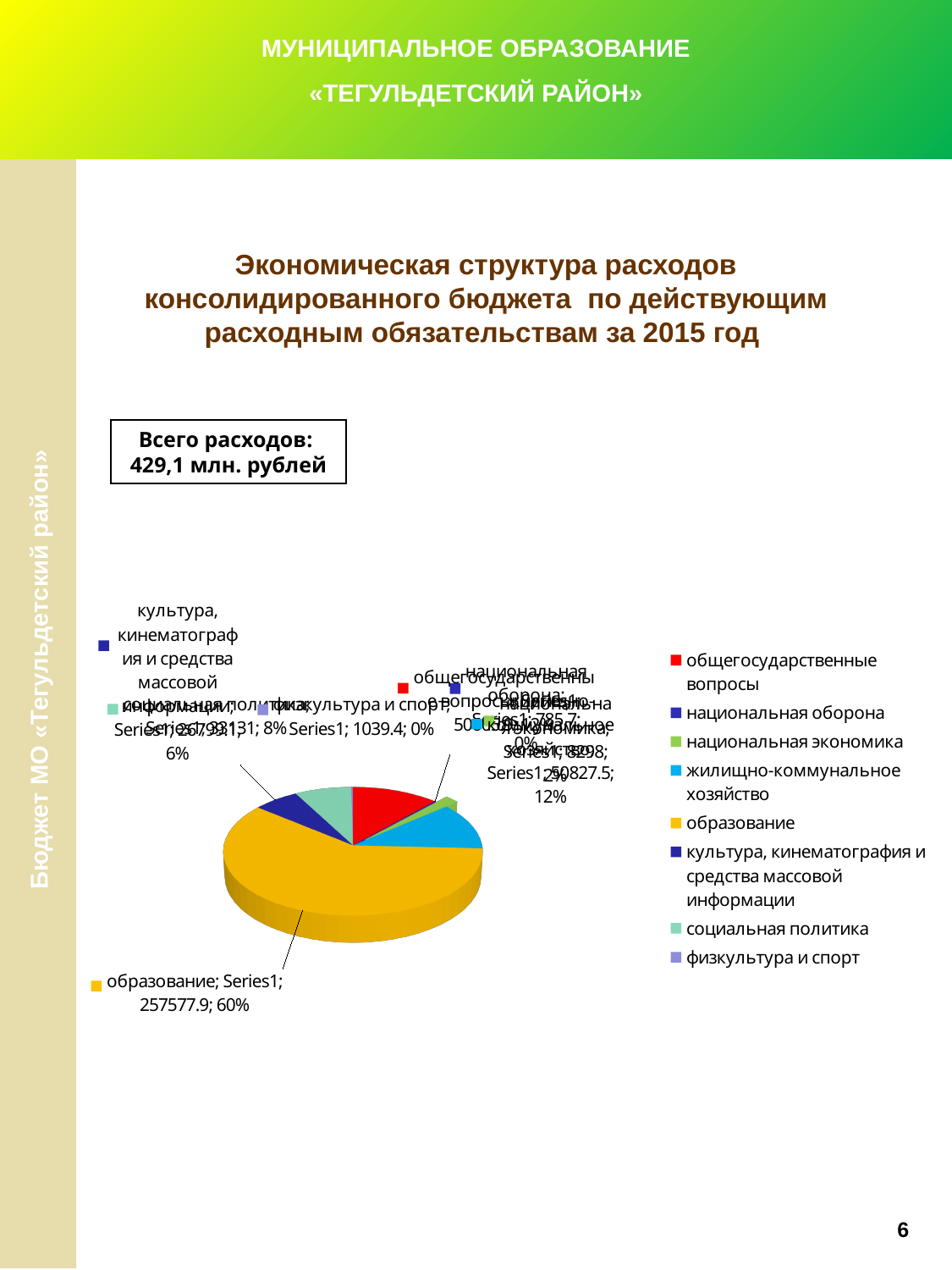
Which has the larger share of the pie: образование or жилищно-коммунальное хозяйство? образование What is the value shown for физкультура и спорт in the pie chart? 1039.4 What total expenditure amount is stated in the box above the chart? 429,1 млн. рублей How many categories does the legend of the pie chart list? 8 What share of the pie does культура, кинематография и средства массовой информации account for? 6% What is the value shown for жилищно-коммунальное хозяйство in the pie chart? 50827.5 Which category has the largest share of the pie chart? образование What share of the pie does образование account for? 60% What kind of chart is shown on the slide? pie chart What share of the pie does жилищно-коммунальное хозяйство account for? 12% What is the value shown for образование in the pie chart? 257577.9 By how many percentage points does the share of образование exceed the share of жилищно-коммунальное хозяйство? 48%